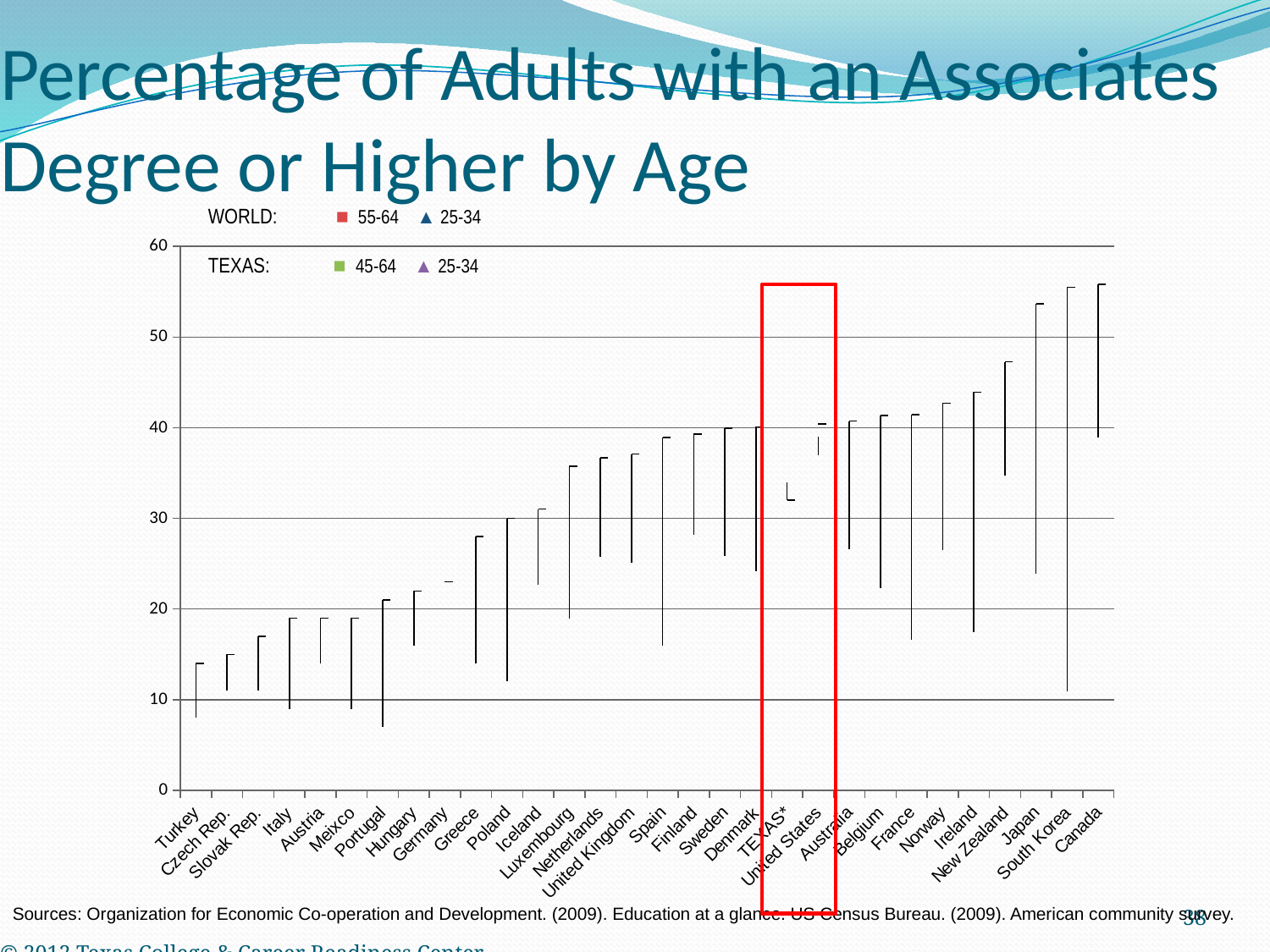
Which two categories are outlined by the red box? TEXAS* and United States Is the upper value for Japan greater or less than 50? greater What is the title of the chart? Percentage of Adults with an Associates Degree or Higher by Age Do the upper values generally rise or fall moving from left to right along the x axis? rise Is the lower value for South Korea greater or less than 20? less Is the upper value for Turkey greater or less than 20? less Which has a higher upper value, Canada or Turkey? Canada How many countries/categories are shown along the x axis? 30 How many series does the legend list? 4